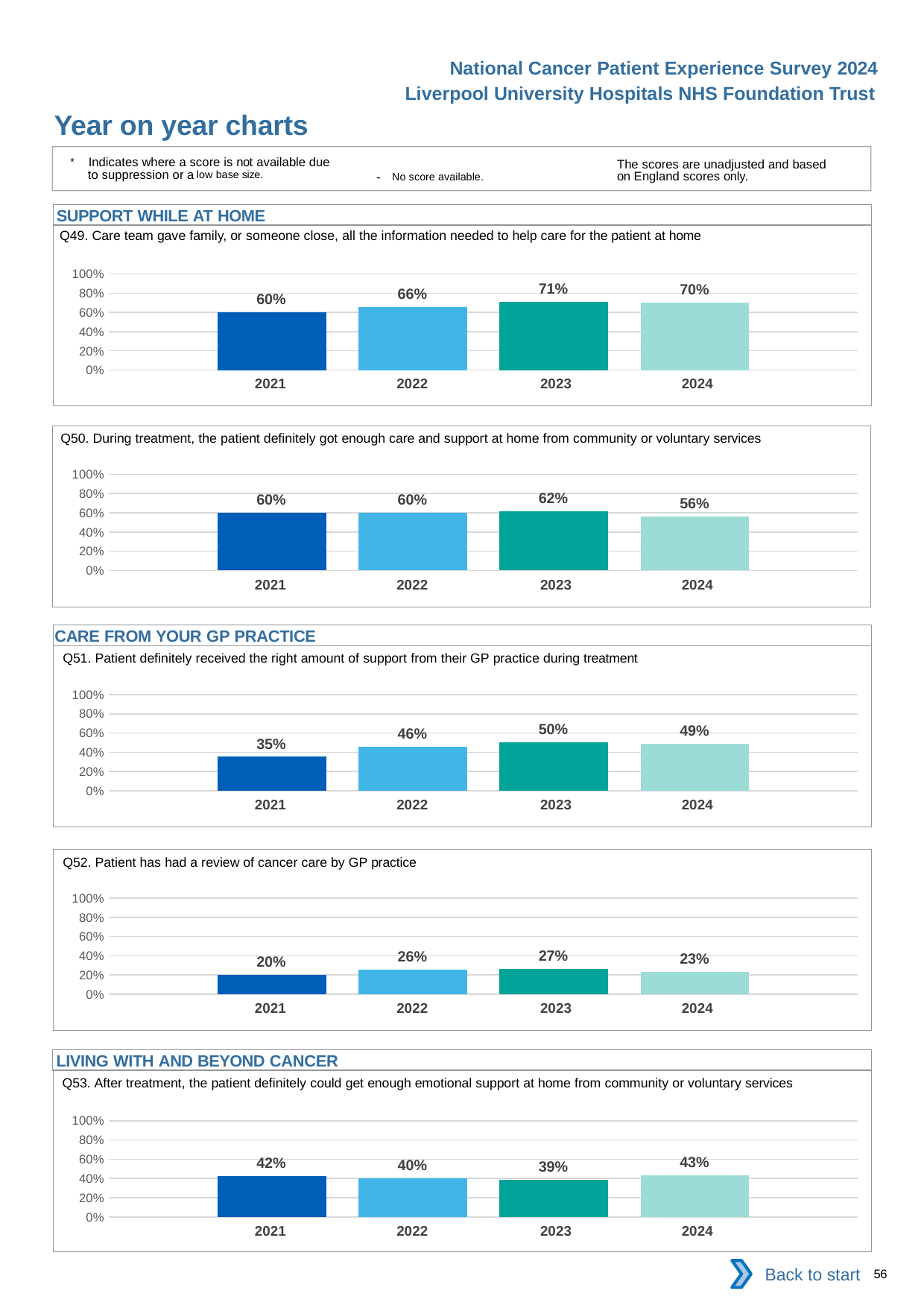
In the Q53 chart, what is the value for 2024? 43% In the Q52 chart, which year has the highest value? 2023 In the Q53 chart, what is the difference between the 2021 and 2023 values? 3% Which section heading appears above the Q53 chart? LIVING WITH AND BEYOND CANCER What kind of chart is the Q50 chart? bar chart In the Q49 chart, is the value for 2022 larger or smaller than the value for 2024? smaller In the Q51 chart, do the values rise or fall from 2021 to 2023? rise In the Q50 chart, which year has the lowest value? 2024 In the Q52 chart, how many years are plotted? 4 In the Q50 chart, what is the value for 2022? 60% In the Q51 chart, what is the difference between the 2023 and 2021 values? 15% In the Q49 chart, what is the value for 2023? 71%